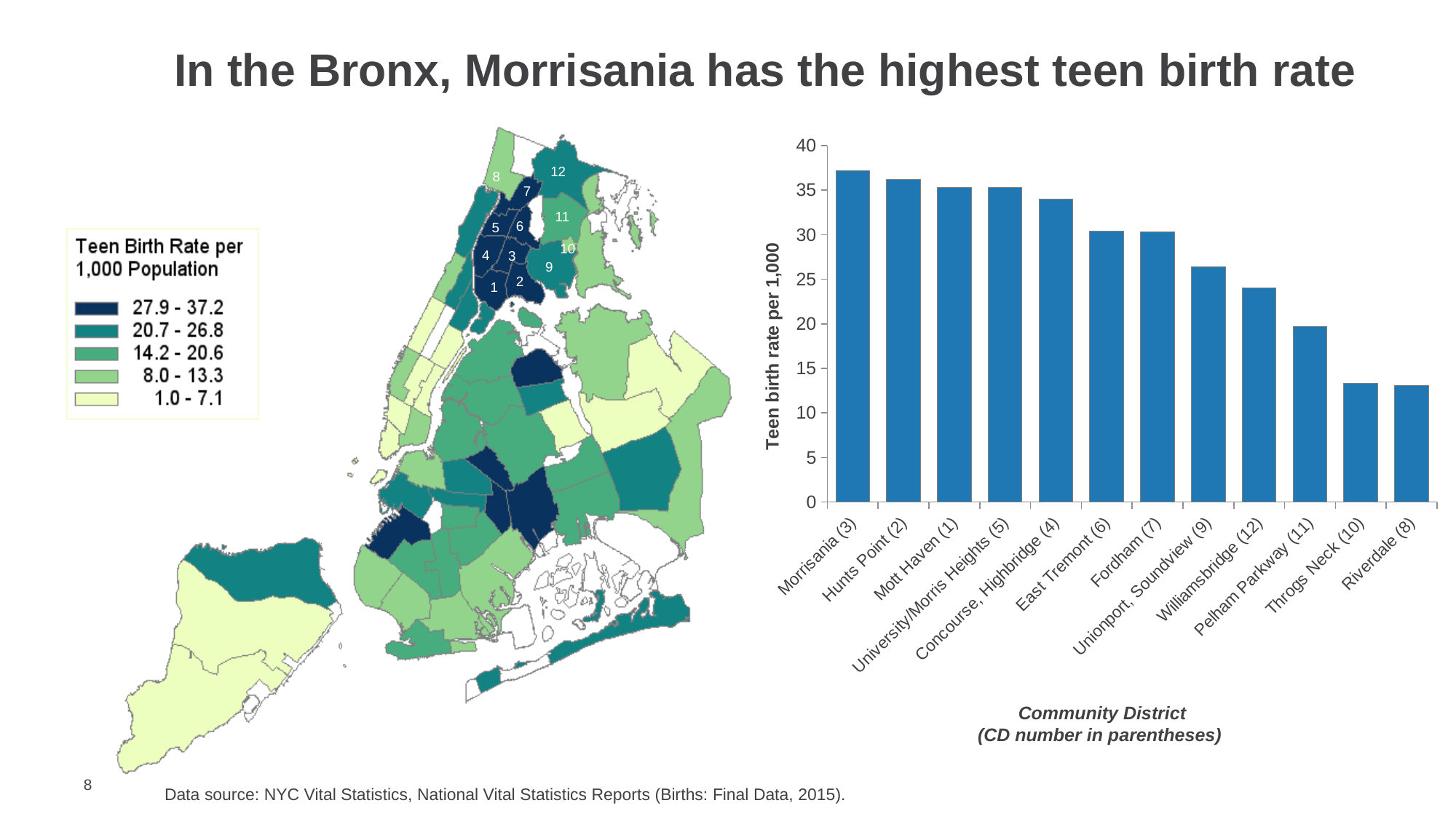
In the bar chart, is the teen birth rate for Williamsbridge (12) greater or less than 25? less In the bar chart, is the teen birth rate for Morrisania (3) greater or less than 35? greater What kind of chart is shown on the right side of the slide? bar chart How many community districts are plotted in the bar chart? 12 In the bar chart, which community district has the lowest teen birth rate? Riverdale (8) In the bar chart, is the teen birth rate for Throgs Neck (10) greater or less than 10? greater In the bar chart, which has a higher teen birth rate, Hunts Point (2) or Fordham (7)? Hunts Point (2) What is the y-axis title of the bar chart? Teen birth rate per 1,000 In the bar chart, which has a lower teen birth rate, Pelham Parkway (11) or Unionport, Soundview (9)? Pelham Parkway (11) In the bar chart, which community district has the highest teen birth rate? Morrisania (3) Do the bars in the bar chart rise or fall from left to right? fall